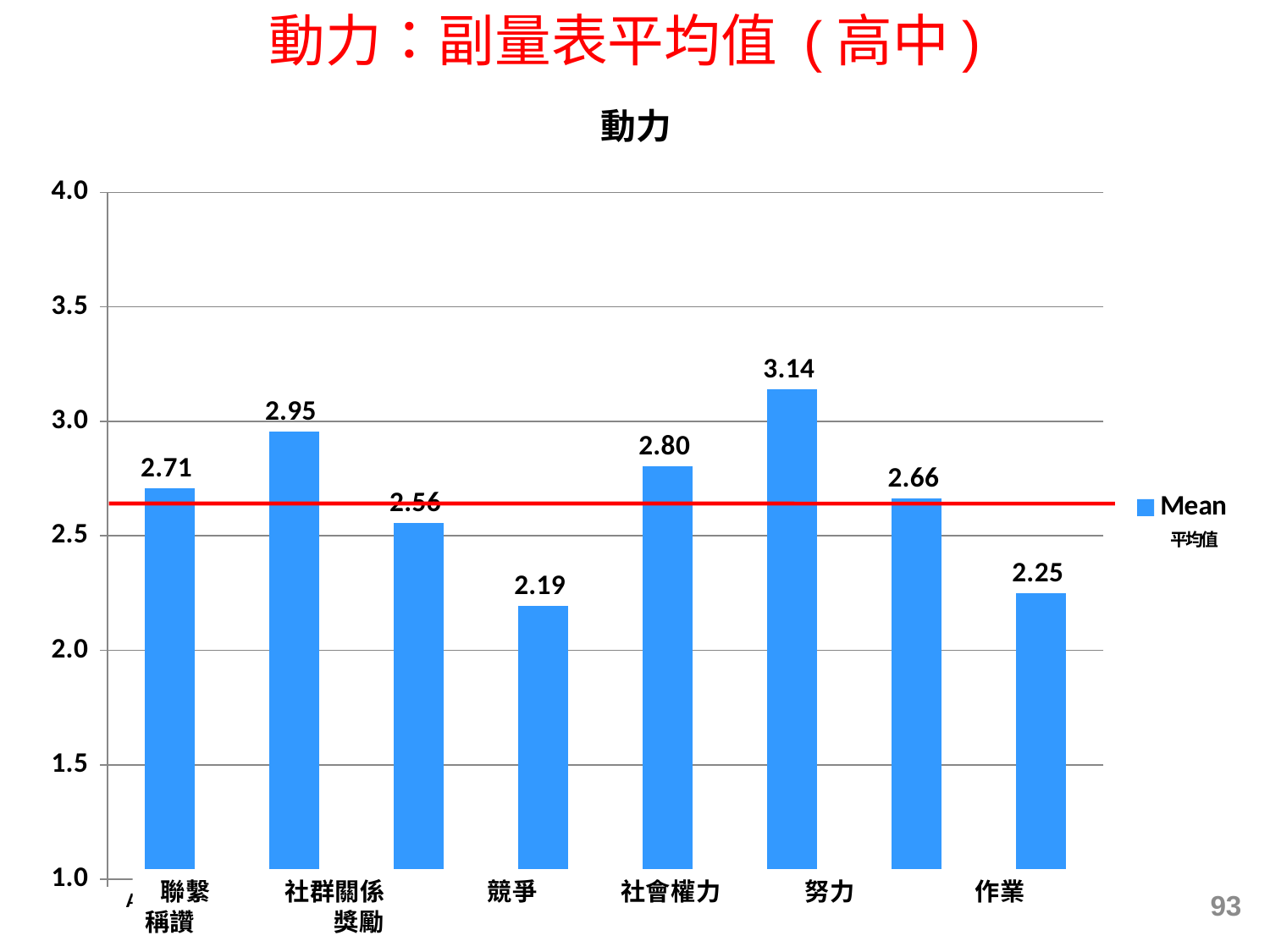
What is the highest value shown on any bar in the chart? 3.14 What is the maximum value shown on the vertical axis? 4.0 How many bars have a value less than 2.5? 2 What is the title of the chart? 動力 What is the lowest value shown on any bar in the chart? 2.19 What is the difference between the highest bar value (3.14) and the lowest bar value (2.19)? 0.95 How many bars have a value greater than 3.0? 1 Which is larger, the bar labelled 2.95 or the bar labelled 2.80? 2.95 How many bars are plotted in the chart? 8 What type of chart is shown on the slide? bar chart